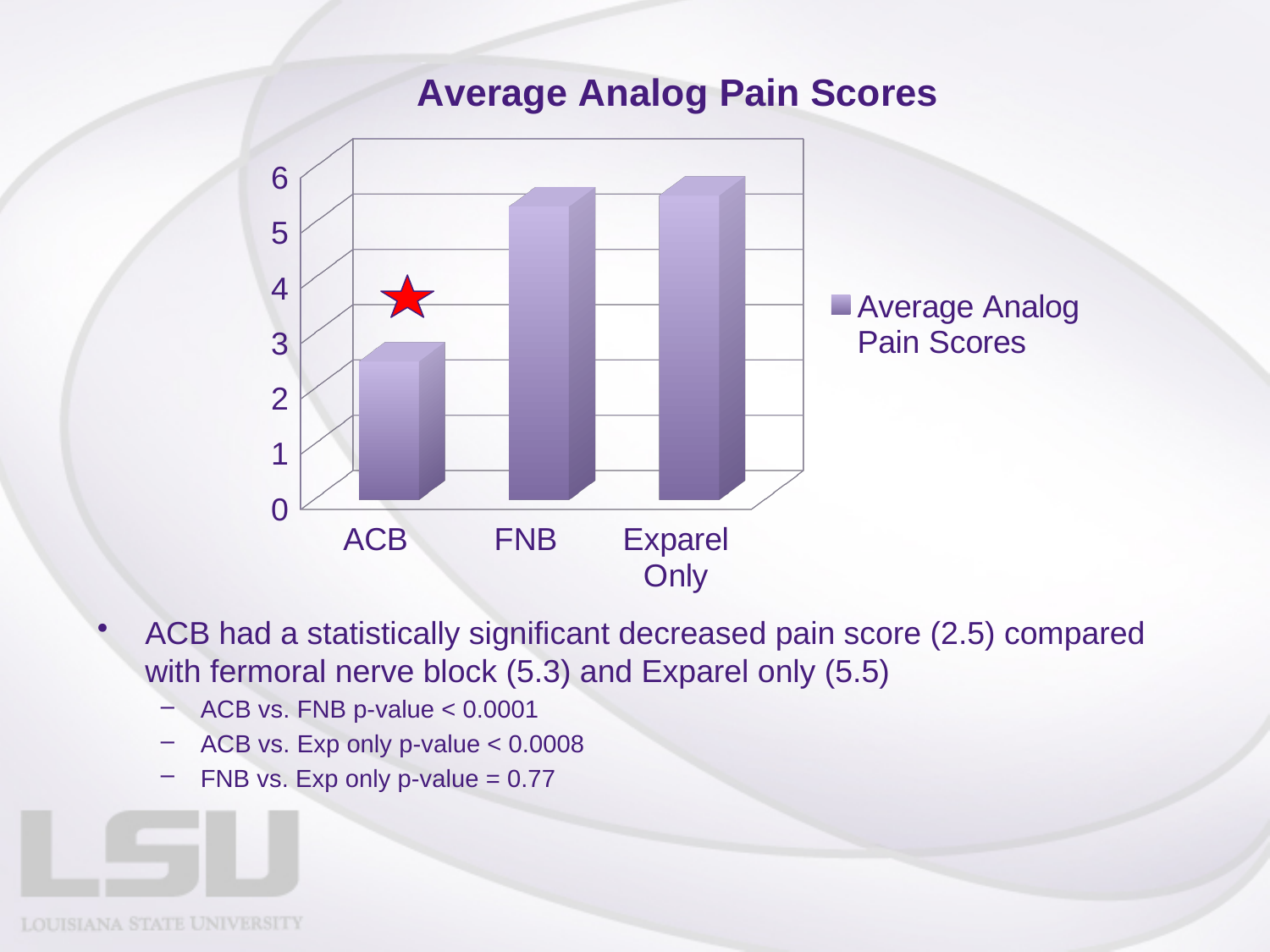
According to the slide, what is the average analog pain score for ACB? 2.5 According to the slide, what is the difference between the average analog pain scores for Exparel only (5.5) and ACB (2.5)? 3.0 Is the average analog pain score for Exparel Only greater or less than 4? greater Is the average analog pain score for ACB greater or less than 3? less Which has a larger average analog pain score, ACB or FNB? FNB What kind of chart is shown on the slide? bar chart What is the title of the chart? Average Analog Pain Scores How many series does the chart legend list? 1 How many categories are shown on the x axis of the chart? 3 Is the average analog pain score for FNB greater or less than 5? greater Which category has the lowest average analog pain score? ACB Which category has the highest average analog pain score? Exparel Only